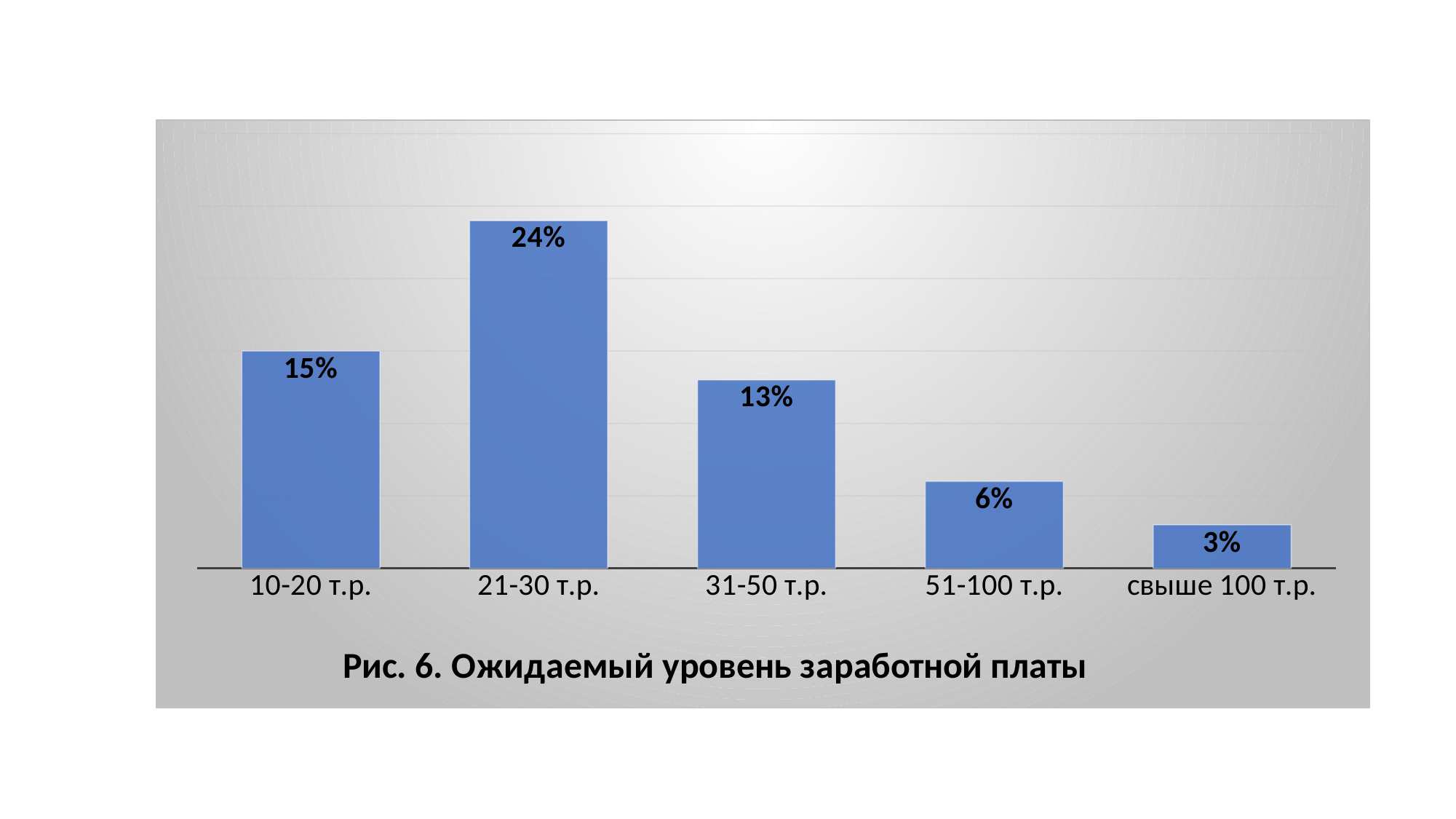
Which category has the lowest value? свыше 100 т.р. What is the difference between the values for 21-30 т.р. and 31-50 т.р.? 11% What is the value for the свыше 100 т.р. category? 3% What is the caption of the chart? Рис. 6. Ожидаемый уровень заработной платы Which is larger, the value for 10-20 т.р. or the value for 31-50 т.р.? 10-20 т.р. Which category has the highest value? 21-30 т.р. What is the difference between the values for 10-20 т.р. and 51-100 т.р.? 9% What is the value for the 21-30 т.р. category? 24% What is the value for the 10-20 т.р. category? 15% What kind of chart is shown on the slide? Bar chart How many categories are shown on the chart? 5 What is the value for the 51-100 т.р. category? 6%